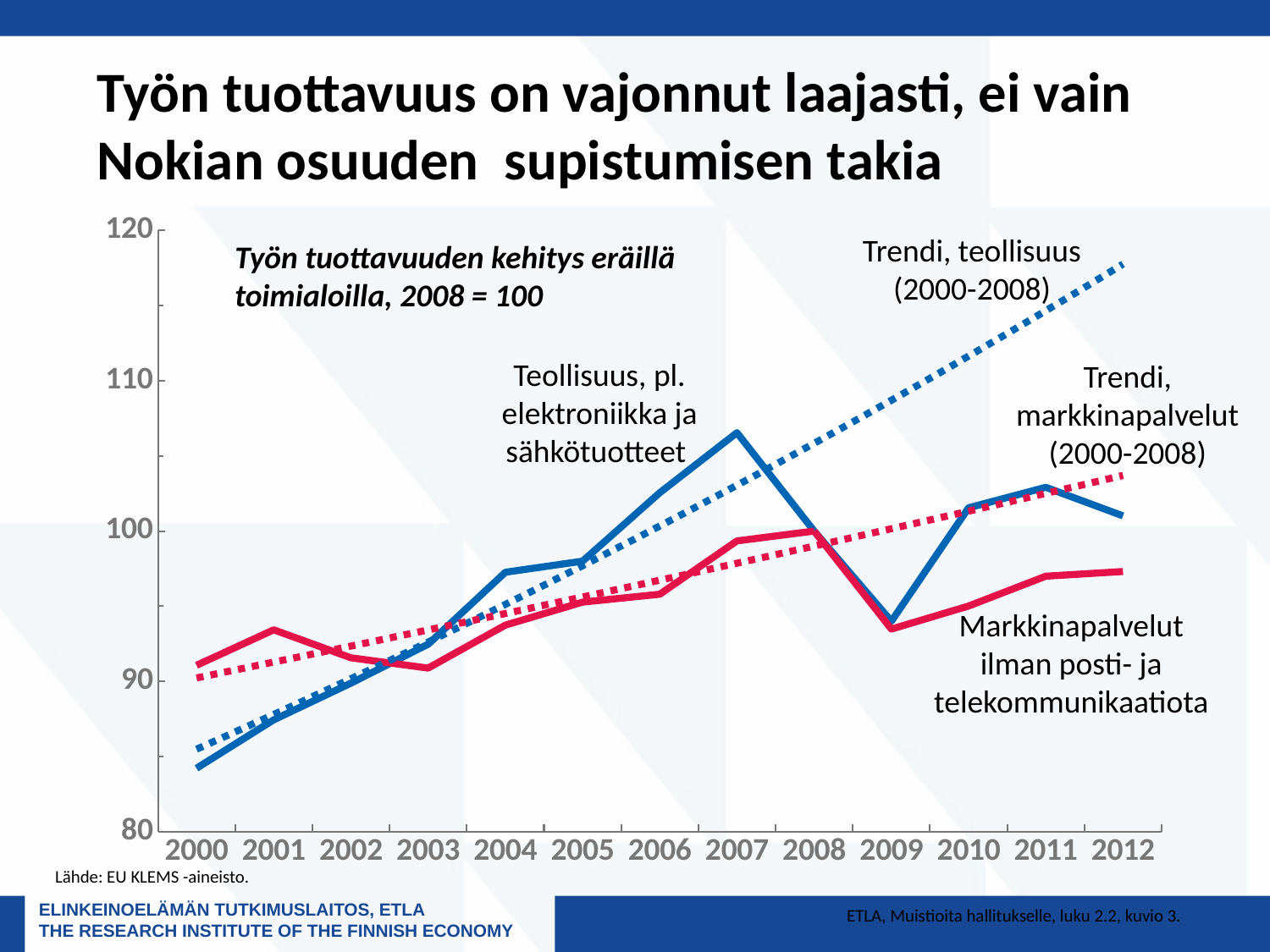
Is the value for Markkinapalvelut ilman posti- ja telekommunikaatiota in 2009 greater or less than 100? less In which year is the Teollisuus, pl. elektroniikka ja sähkötuotteet line at its lowest value? 2000 In which year does the Teollisuus, pl. elektroniikka ja sähkötuotteet line reach its highest value? 2007 Does the Teollisuus, pl. elektroniikka ja sähkötuotteet line rise or fall from 2000 to 2007? rise Is the value for Teollisuus, pl. elektroniikka ja sähkötuotteet in 2007 greater or less than 100? greater Is the value for Teollisuus, pl. elektroniikka ja sähkötuotteet in 2000 greater or less than 90? less In 2007, which line is higher: Teollisuus, pl. elektroniikka ja sähkötuotteet or Markkinapalvelut ilman posti- ja telekommunikaatiota? Teollisuus, pl. elektroniikka ja sähkötuotteet What is the base year of the index used in the chart, according to the chart subtitle? 2008 = 100 How many years are shown on the x axis of the chart? 13 In 2000, which line is higher: Teollisuus, pl. elektroniikka ja sähkötuotteet or Markkinapalvelut ilman posti- ja telekommunikaatiota? Markkinapalvelut ilman posti- ja telekommunikaatiota What kind of chart is shown on the slide? line chart